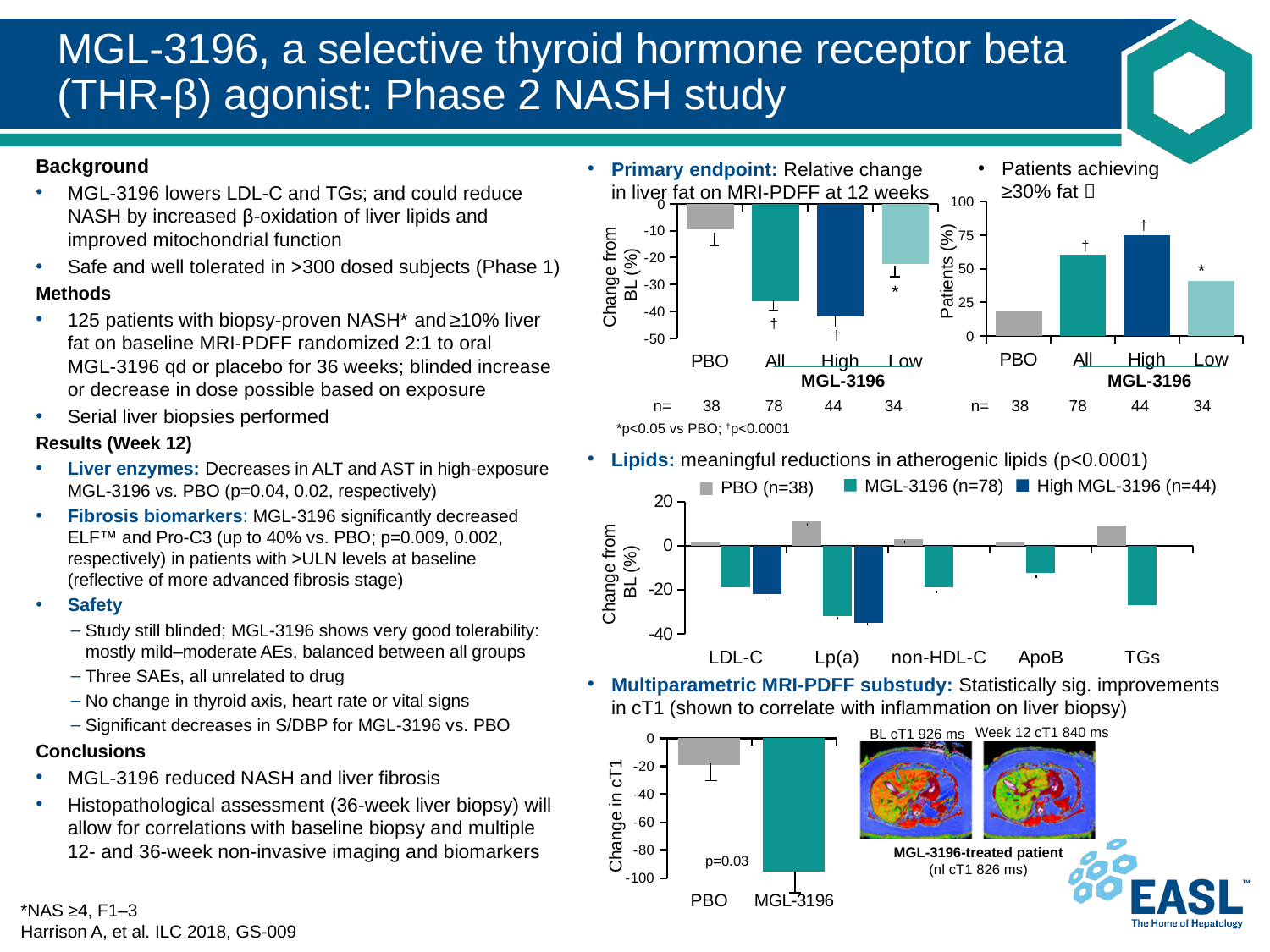
In the chart of patients achieving ≥30% fat reduction, which group has the lowest percentage of patients? PBO In the primary endpoint chart (relative change in liver fat), is the value for the PBO group greater or less than -20? greater In the Lipids chart, is the High MGL-3196 (n=44) value for Lp(a) greater or less than -20? less In the chart of patients achieving ≥30% fat reduction, which group has the highest percentage of patients? High In the chart of patients achieving ≥30% fat reduction, is the value for the All MGL-3196 group greater or less than 50? greater How many lipid categories are plotted on the x axis of the Lipids chart? 5 How many groups are plotted in the primary endpoint chart (relative change in liver fat)? 4 How many series does the legend of the Lipids chart list? 3 In the cT1 chart at the bottom, which group shows the larger decrease in cT1, PBO or MGL-3196? MGL-3196 In the primary endpoint chart (relative change in liver fat on MRI-PDFF at 12 weeks), which group shows the largest decrease from baseline? High